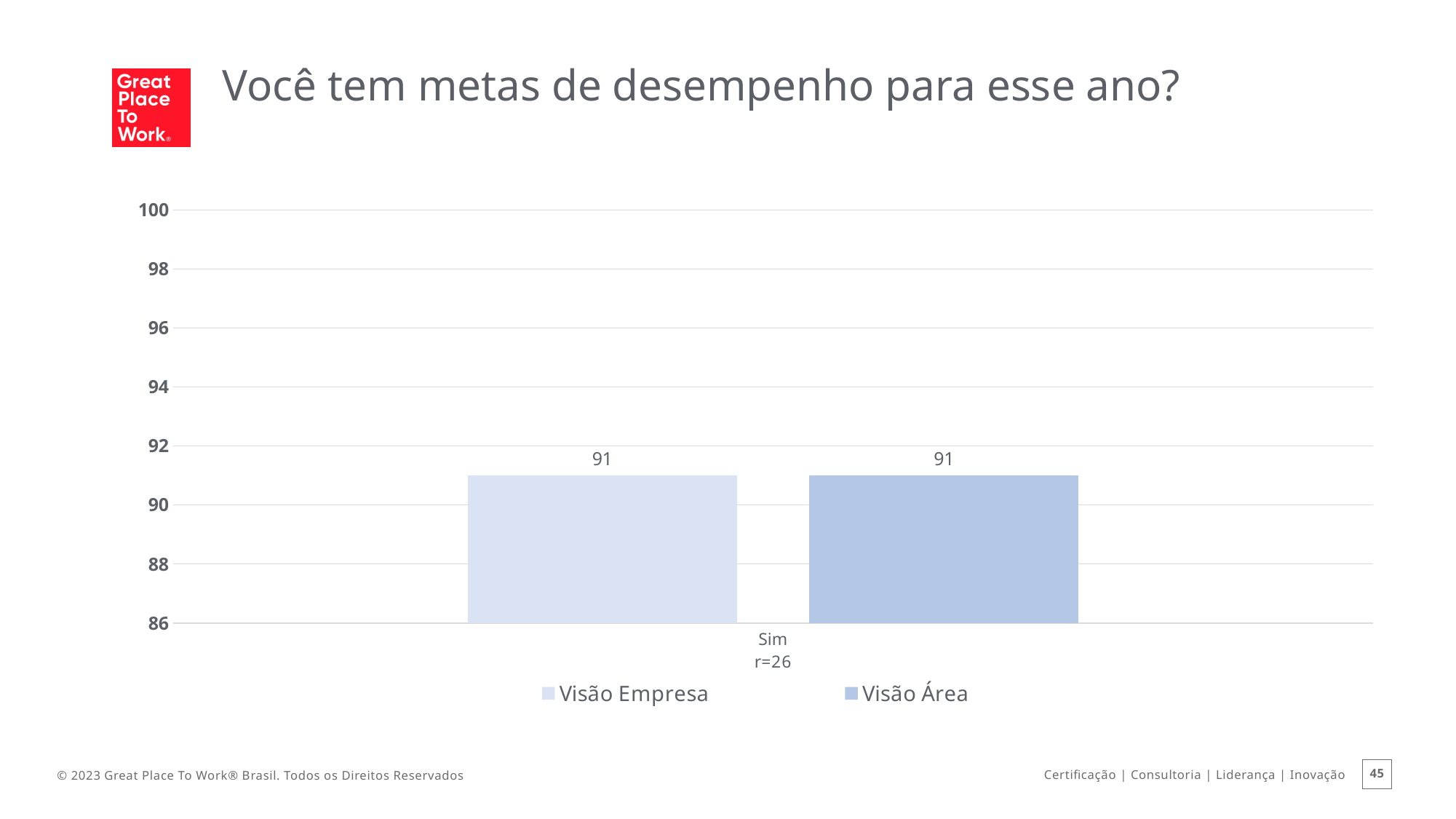
What is the title of the slide? Você tem metas de desempenho para esse ano? What is the value for Visão Área for the category Sim? 91 What is the highest value shown on the y axis? 100 How many categories are shown on the x axis? 1 How many series does the legend list? 2 What is the value for Visão Empresa for the category Sim? 91 What is the number of respondents (r) shown under the category Sim? 26 What kind of chart is shown on the slide? bar chart Is the value for Visão Área greater or less than 92? less Is the value for Visão Empresa greater or less than 90? greater What is the difference between the Visão Empresa and Visão Área values for Sim? 0 What are the two series named in the legend? Visão Empresa and Visão Área